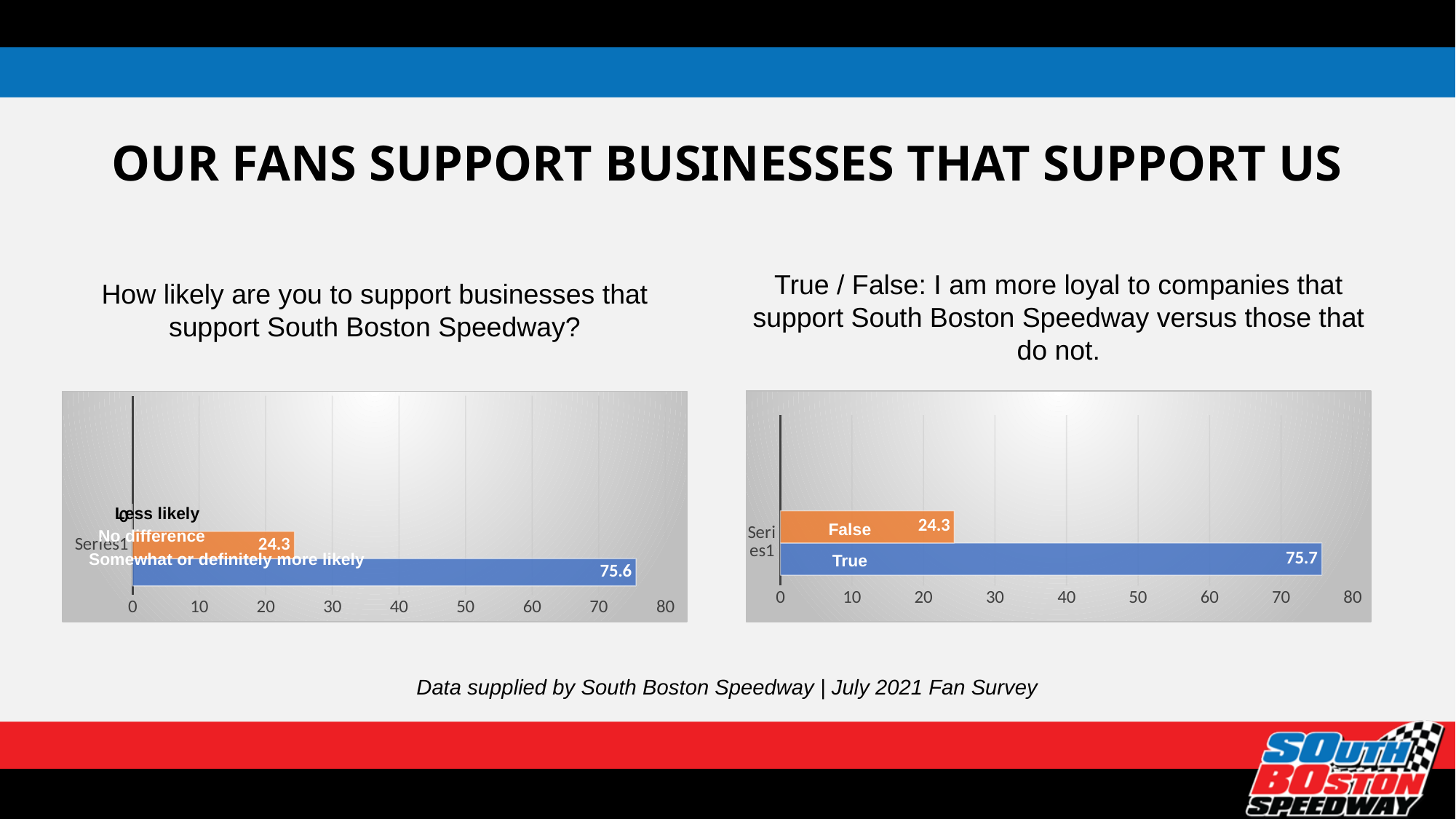
In the right chart (True / False: I am more loyal to companies that support South Boston Speedway), what is the value for "True"? 75.7 In the right chart (True / False), which response has the higher value, True or False? True In the left chart (How likely are you to support businesses that support South Boston Speedway?), what is the value for "No difference"? 24.3 In the right chart (True / False: I am more loyal to companies that support South Boston Speedway), what is the value for "False"? 24.3 What kind of chart is the right chart (True / False)? bar chart In the right chart (True / False), is the value for False greater or less than 30? less In the left chart (How likely are you to support businesses that support South Boston Speedway?), what is the difference between "Somewhat or definitely more likely" and "No difference"? 51.3 In the right chart (True / False), what colour is the True bar? blue In the right chart (True / False), what is the difference between the True and False values? 51.4 In the left chart (How likely are you to support businesses that support South Boston Speedway?), which response has the highest value? Somewhat or definitely more likely In the right chart (True / False), what is the highest value shown on the horizontal axis? 80 In the left chart (How likely are you to support businesses that support South Boston Speedway?), what is the value for "Somewhat or definitely more likely"? 75.6